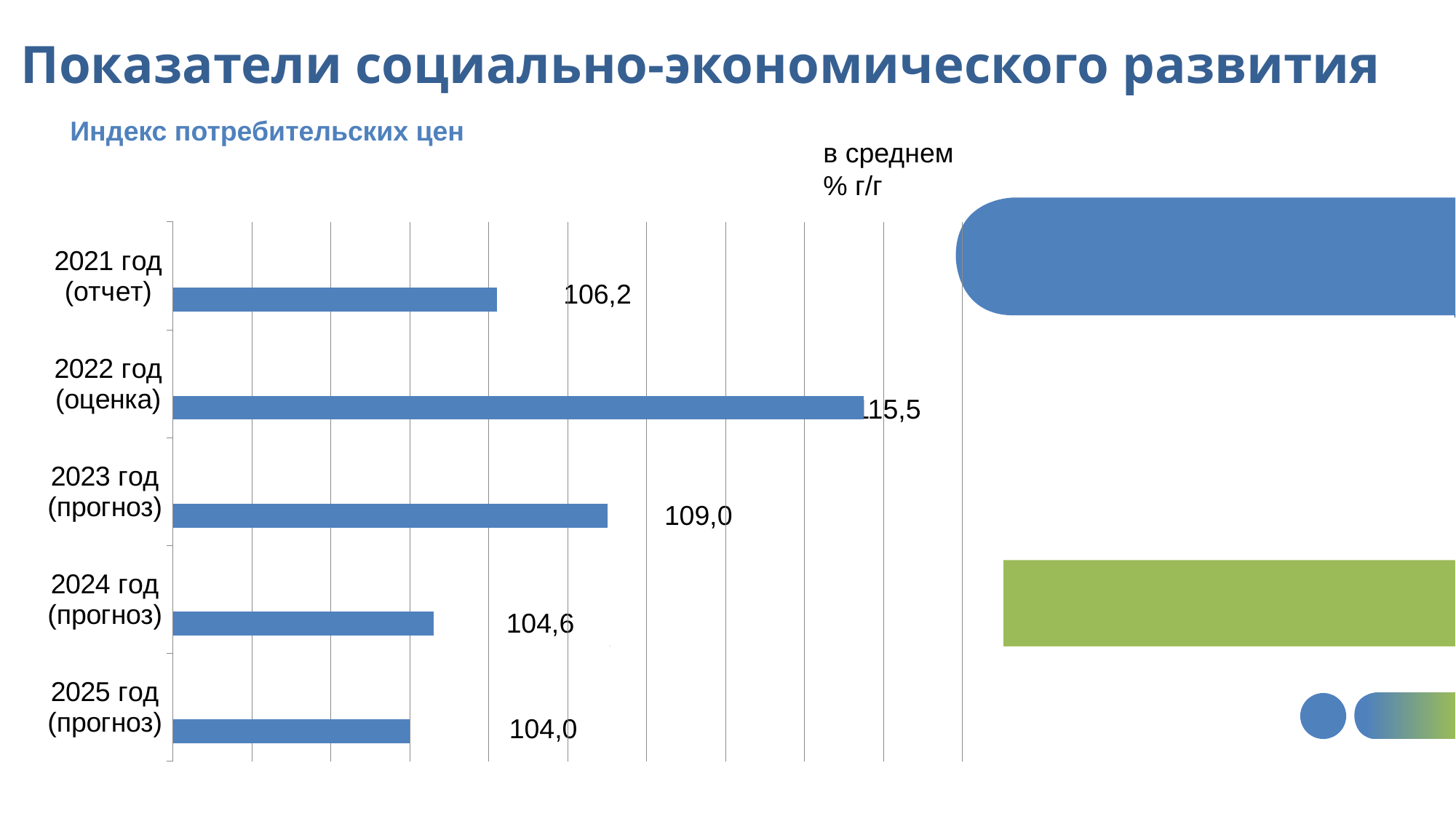
What is the value for 2021 год (отчет)? 106,2 What is the difference between the values for 2021 год (отчет) and 2024 год (прогноз)? 1,6 What is the value for 2024 год (прогноз)? 104,6 Which is larger, the value for 2021 год (отчет) or the value for 2023 год (прогноз)? 2023 год (прогноз) What is the title of the chart? Индекс потребительских цен What is the difference between the values for 2023 год (прогноз) and 2025 год (прогноз)? 5,0 Which category has the highest value? 2022 год (оценка) What is the value for 2023 год (прогноз)? 109,0 What is the value for 2025 год (прогноз)? 104,0 What kind of chart is shown on the slide? Bar chart How many categories are shown in the chart? 5 Which category has the lowest value? 2025 год (прогноз)